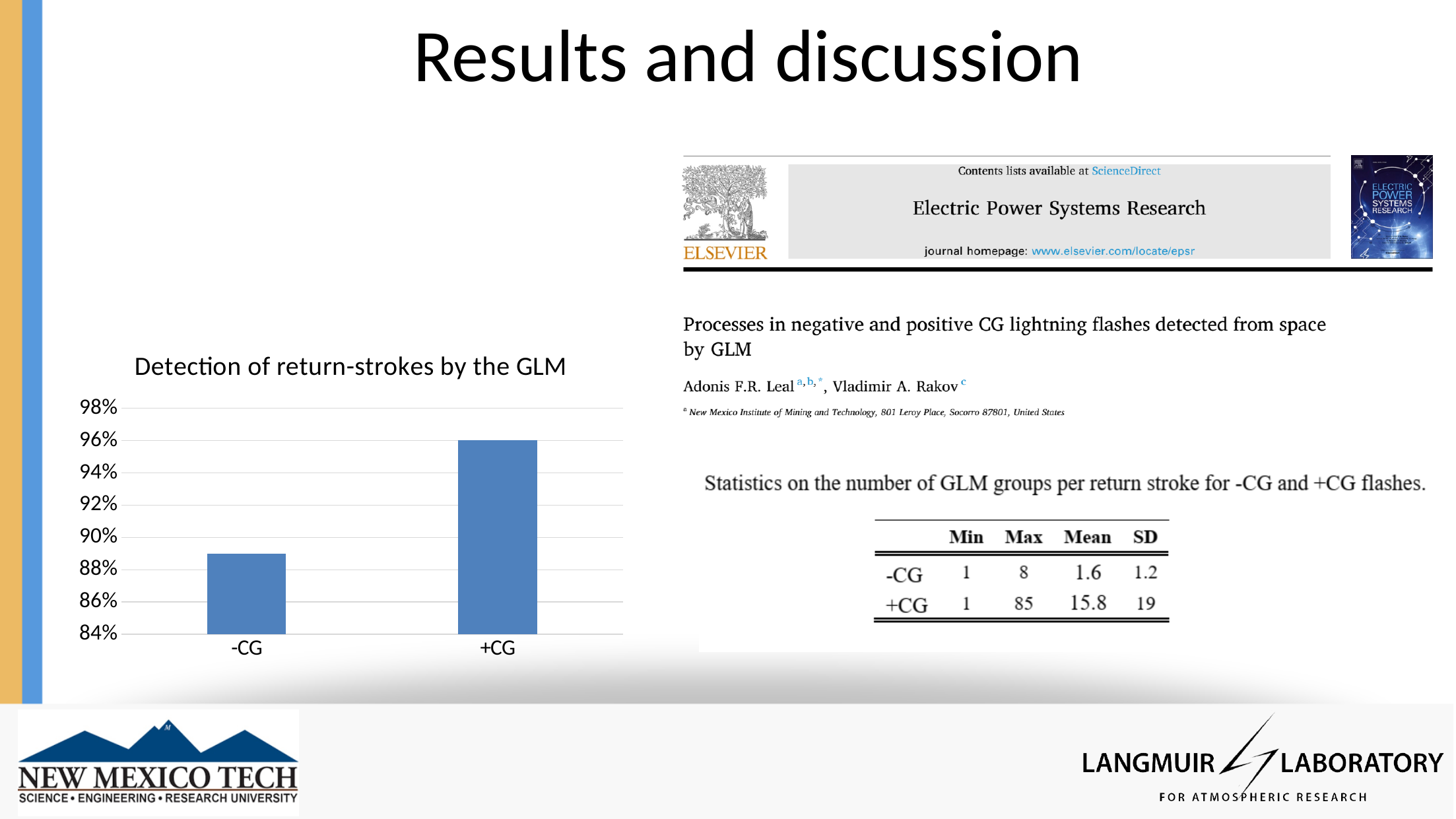
Is the value for +CG greater or less than 94%? greater Which is larger in the chart, the value for -CG or the value for +CG? +CG Is the value for -CG greater or less than 88%? greater What kind of chart is shown on the slide? bar chart What is the lowest value shown on the chart's vertical axis? 84% Do the values rise or fall from -CG to +CG along the x axis? rise What is the value for +CG in the chart? 96% Which category has the lowest value in the chart? -CG Is the value for -CG greater or less than 90%? less What is the title of the chart on the slide? Detection of return-strokes by the GLM Which category has the highest value in the chart? +CG How many categories are plotted in the chart? 2